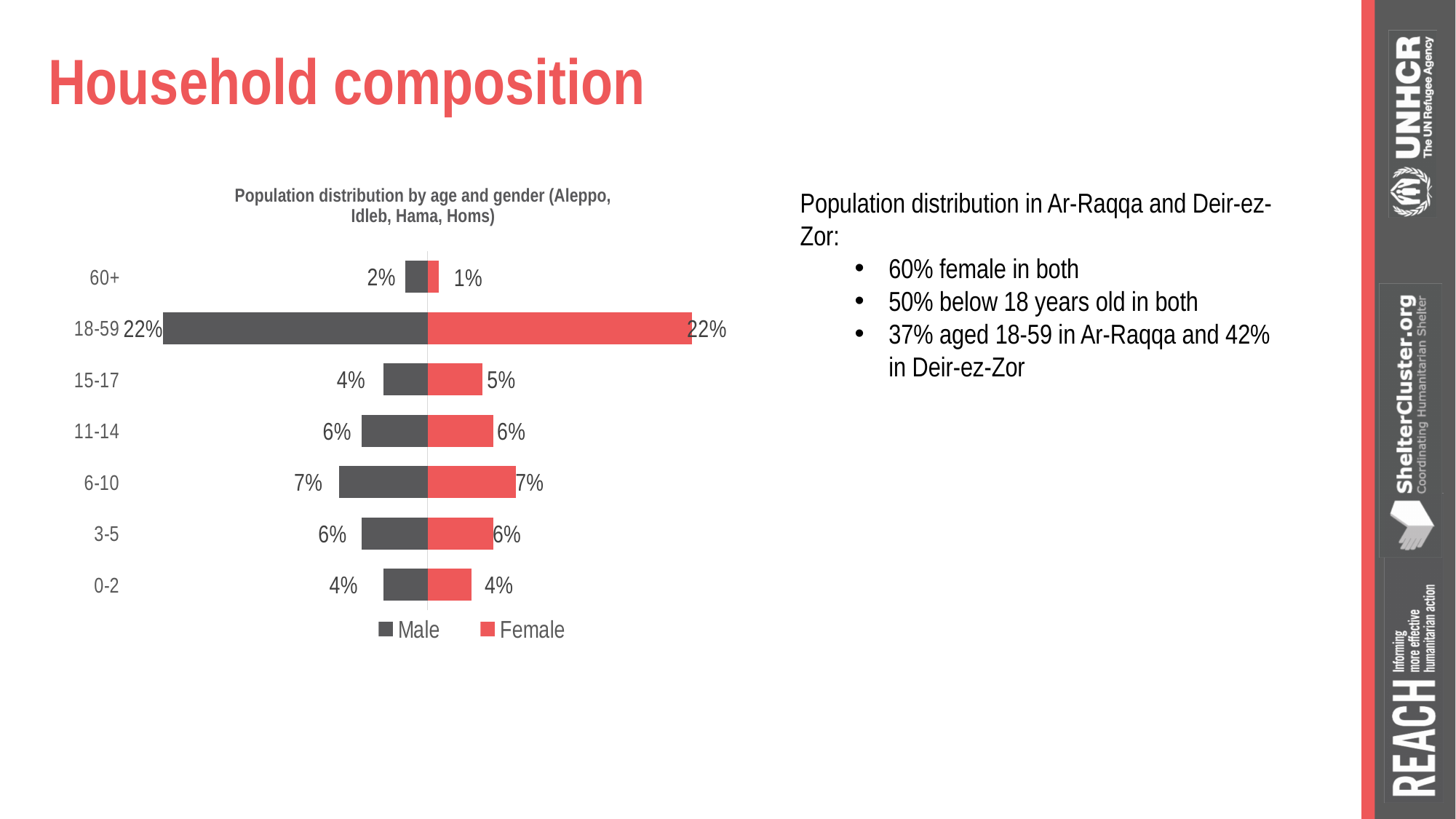
Which age group has the lowest Male value? 60+ What is the difference between the Male value for 18-59 and the Male value for 60+? 20% What is the Female value for the 60+ age group? 1% What is the title of the chart? Population distribution by age and gender (Aleppo, Idleb, Hama, Homs) How many series does the legend list? 2 Which age group has the highest Female value? 18-59 How many age groups are shown on the chart? 7 What is the Male value for the 6-10 age group? 7% Which is larger for the 15-17 age group, the Male value or the Female value? Female What is the Female value for the 15-17 age group? 5% What kind of chart is shown on the slide? Bar chart What is the Male value for the 18-59 age group? 22%